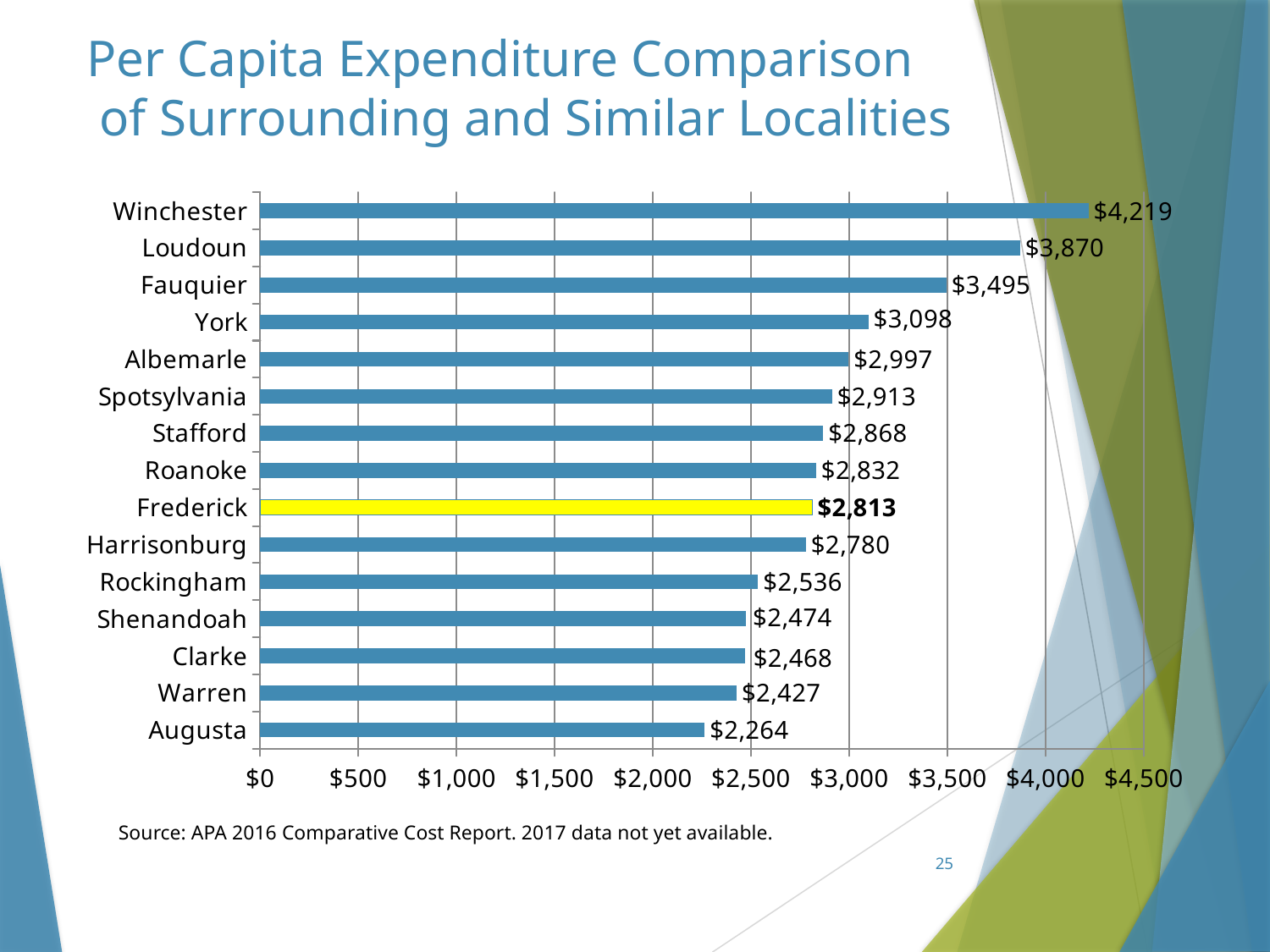
What is the per capita expenditure for Augusta? $2,264 What kind of chart is shown on the slide? Bar chart Which locality has the lowest per capita expenditure? Augusta What is the per capita expenditure for Winchester? $4,219 What is the per capita expenditure for Frederick? $2,813 Which has a higher per capita expenditure, York or Albemarle? York What is the difference between Loudoun's and Fauquier's per capita expenditure? $375 Which locality has the highest per capita expenditure? Winchester Which locality's bar is highlighted in yellow? Frederick Is the value for Rockingham greater or less than $3,000? less What is the difference between Winchester's and Frederick's per capita expenditure? $1,406 How many localities are shown in the chart? 15